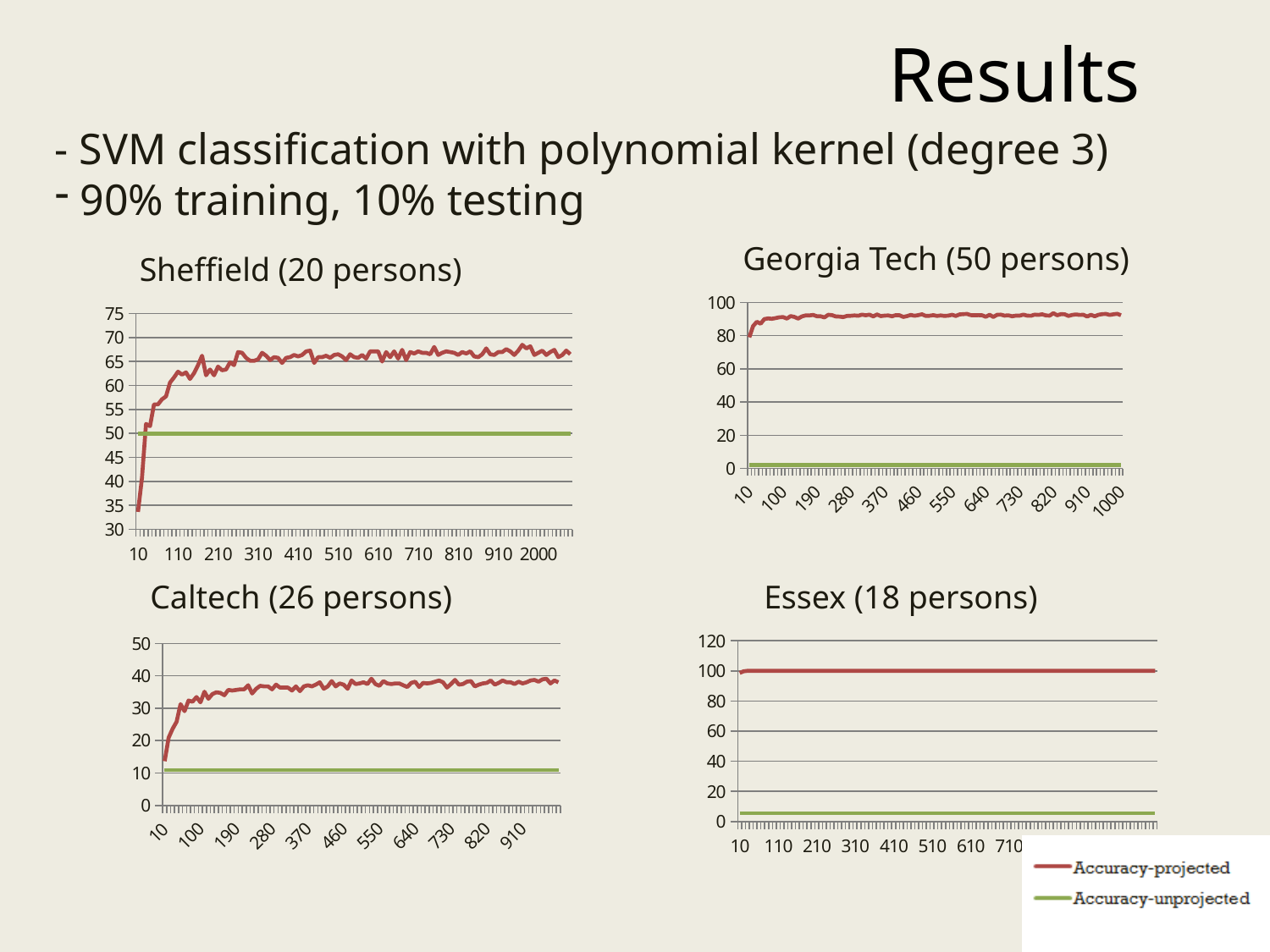
In the Georgia Tech (50 persons) chart, is the Accuracy-projected value at x = 1000 greater or less than 80? greater In the Essex (18 persons) chart, what value does the Accuracy-projected line sit at? 100 In the Caltech (26 persons) chart, does the Accuracy-projected line rise or fall along the x axis overall? rise How many series does the legend list for the charts on this slide? 2 In the Essex (18 persons) chart, which series has the higher values, Accuracy-projected or Accuracy-unprojected? Accuracy-projected What colour is the Accuracy-unprojected line in the legend? green In the Sheffield (20 persons) chart, what value does the Accuracy-unprojected line sit at? 50 What kind of chart is the Sheffield (20 persons) chart? line chart In the Caltech (26 persons) chart, is the Accuracy-unprojected value greater or less than 20? less In the Georgia Tech (50 persons) chart, is the Accuracy-unprojected value greater or less than 20? less In the Sheffield (20 persons) chart, does the Accuracy-projected line rise or fall along the x axis overall? rise Which chart on the slide is titled with 50 persons? Georgia Tech (50 persons)